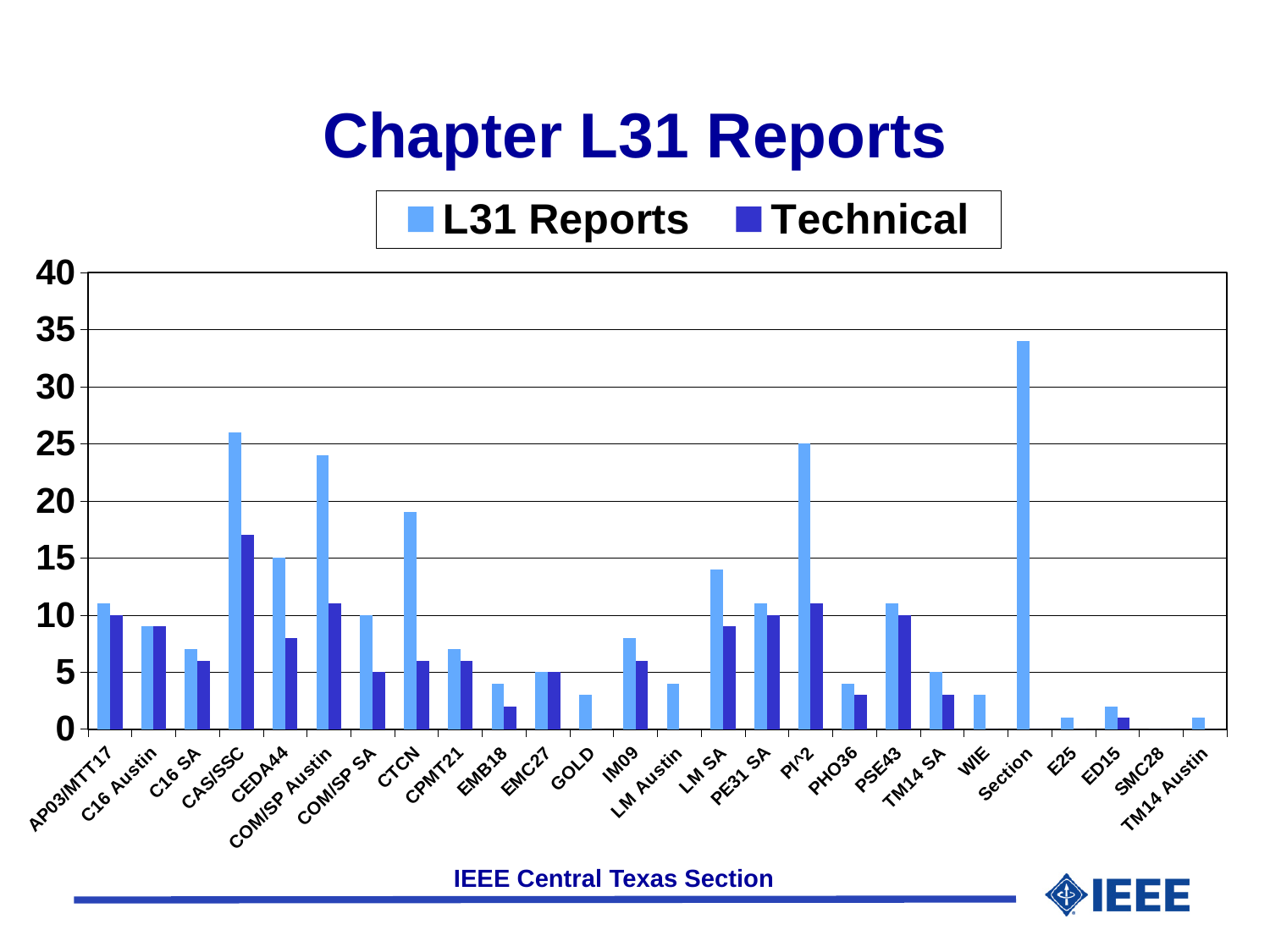
Is the L31 Reports value for Section greater or less than 30? greater What kind of chart is shown on the slide? bar chart What is the Technical value for COM/SP SA? 5 How many series does the legend list? 2 What is the difference between the L31 Reports values for CEDA44 and COM/SP SA? 5 What is the L31 Reports value for CEDA44? 15 What is the L31 Reports value for PI^2? 25 Which is larger, the L31 Reports value for CTCN or for CEDA44? CTCN Which category has the highest L31 Reports value? Section Is the L31 Reports value for CTCN greater or less than 20? less How many chapter categories are shown on the x axis? 26 What are the two series named in the legend? L31 Reports and Technical